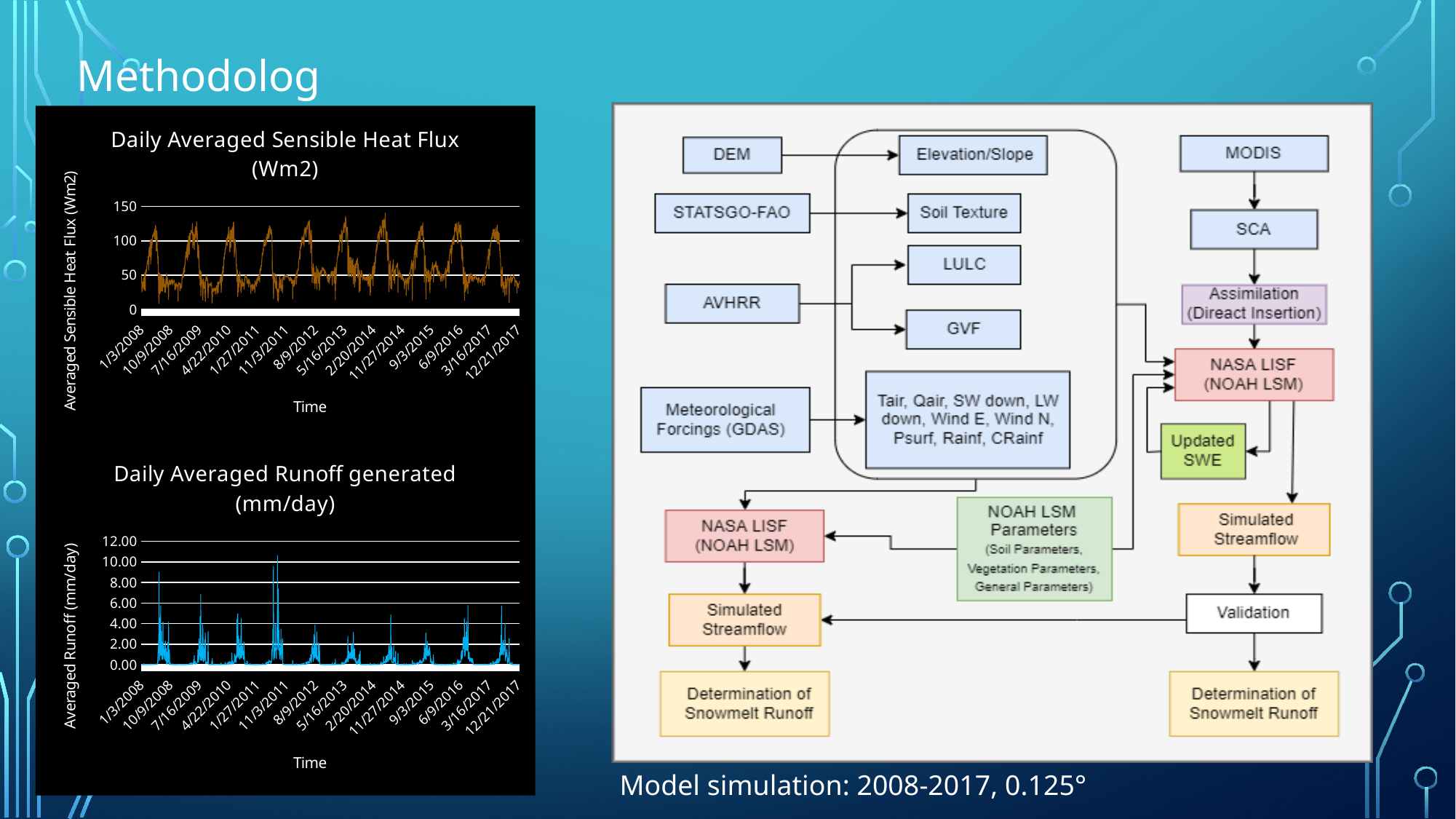
What is the highest tick value shown on the y-axis of the "Daily Averaged Sensible Heat Flux (Wm2)" chart? 150 What is the highest tick value shown on the y-axis of the "Daily Averaged Runoff generated (mm/day)" chart? 12.00 What is the last date label on the x-axis of the "Daily Averaged Runoff generated (mm/day)" chart? 12/21/2017 What kind of chart is the "Daily Averaged Sensible Heat Flux (Wm2)" chart? line chart In the "Daily Averaged Runoff generated (mm/day)" chart, is the highest plotted value greater or less than 8.00? greater In the "Daily Averaged Runoff generated (mm/day)" chart, is the highest plotted value greater or less than 12.00? less What is the first date label on the x-axis of the "Daily Averaged Sensible Heat Flux (Wm2)" chart? 1/3/2008 In the "Daily Averaged Sensible Heat Flux (Wm2)" chart, is the highest plotted value greater or less than 150? less What is the y-axis label of the bottom chart? Averaged Runoff (mm/day) What is the title of the top chart on the slide? Daily Averaged Sensible Heat Flux (Wm2) What kind of chart is the "Daily Averaged Runoff generated (mm/day)" chart? line chart